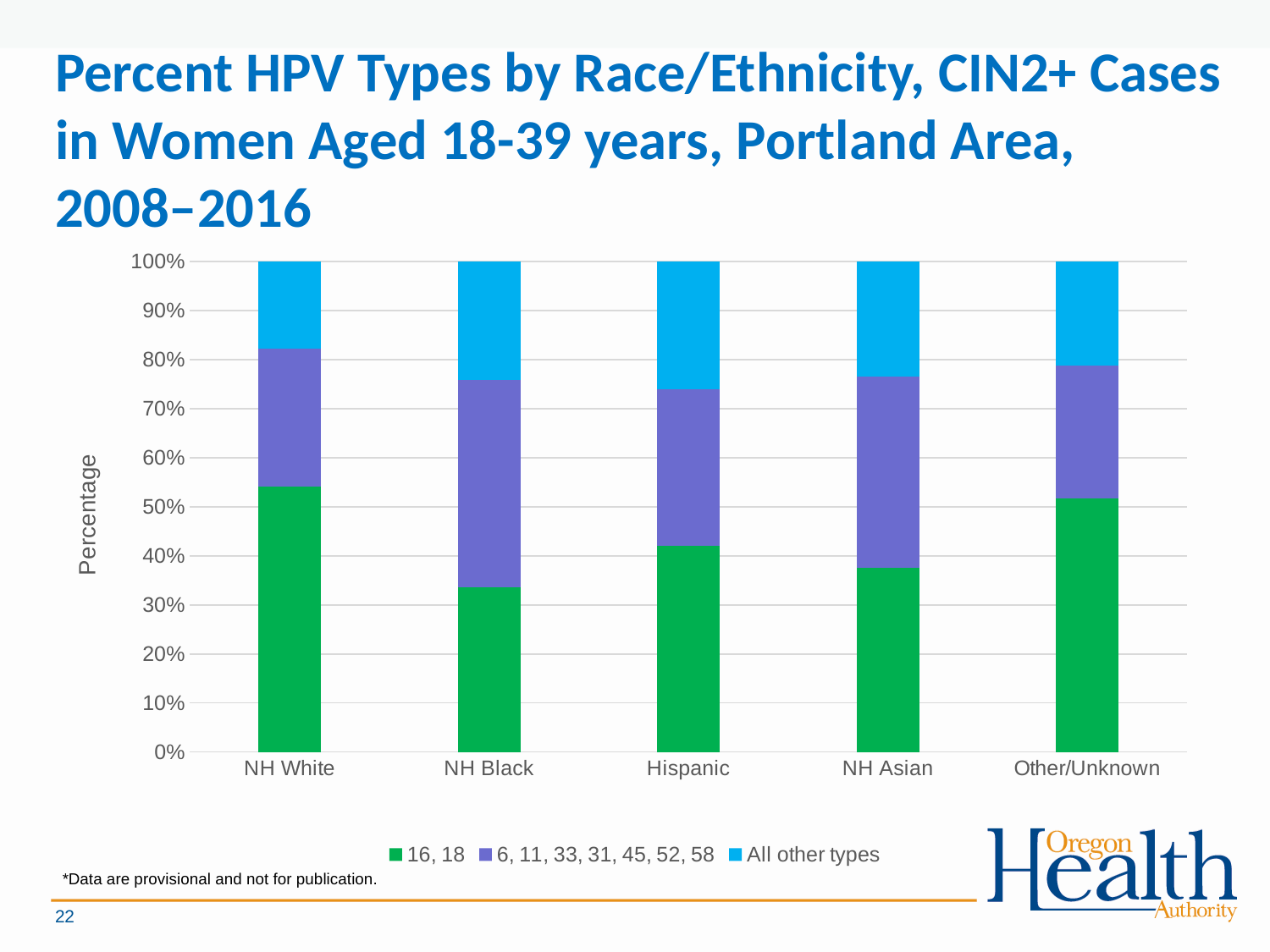
Is the value for 16, 18 in NH Asian greater or less than 40%? less Is the value for 16, 18 in NH White greater or less than 50%? greater What does the stacked bar for NH White total? 100% Is the value for 16, 18 in Other/Unknown greater or less than 40%? greater What kind of chart is shown on the slide? Stacked bar chart Which has the larger 16, 18 share: Hispanic or NH Asian? Hispanic How many series does the legend list? 3 What is the label on the y axis? Percentage Which has the larger 16, 18 share: NH White or NH Black? NH White How many race/ethnicity categories are shown on the x axis? 5 Which race/ethnicity has the lowest share of 16, 18? NH Black